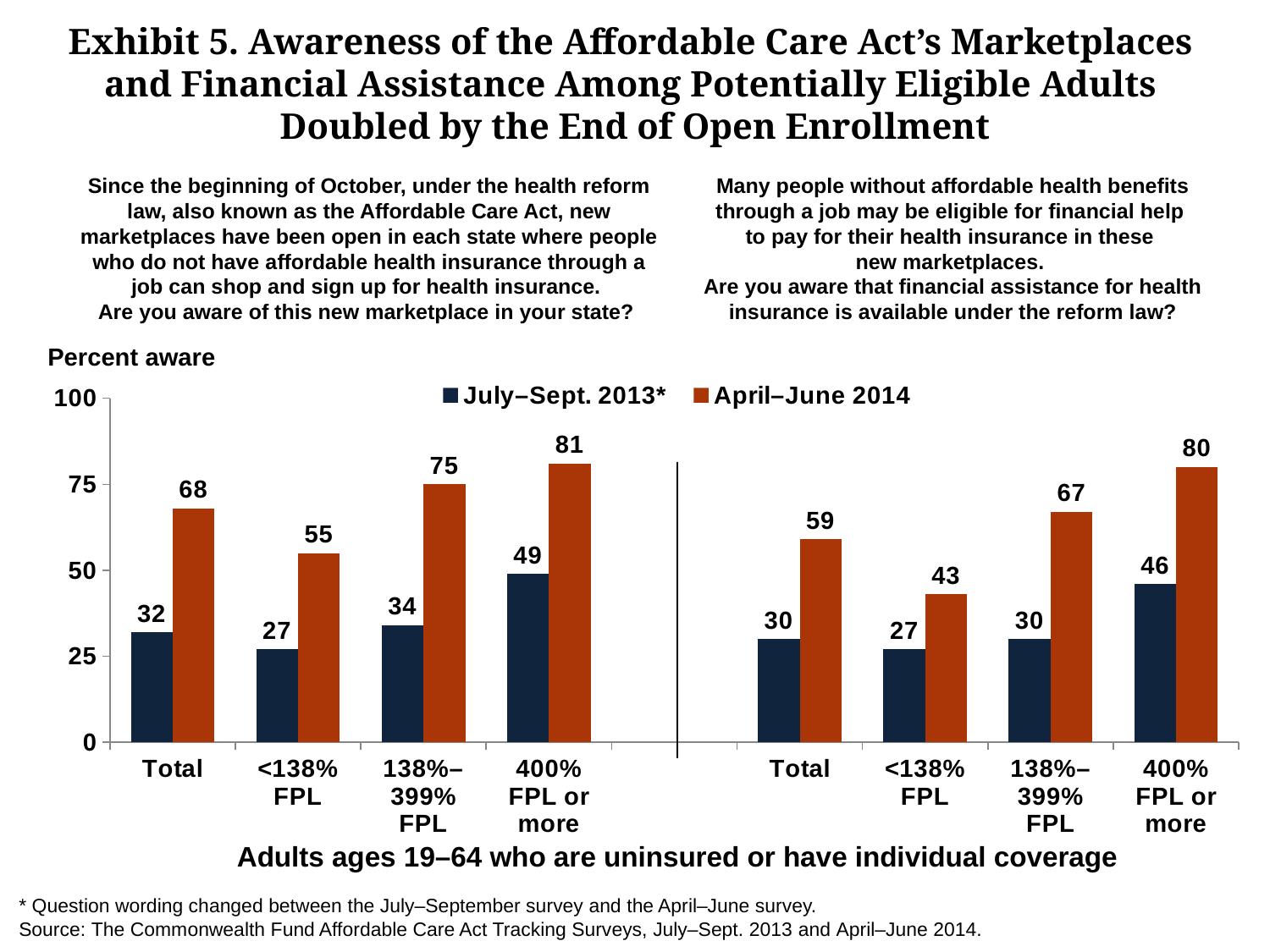
How many income categories are shown in the left panel (awareness of the marketplace)? 4 In the right panel (awareness of financial assistance), is the April–June 2014 value for Total greater or less than 50? greater In the right panel (awareness of financial assistance), what is the value for 400% FPL or more in July–Sept. 2013? 46 In the left panel (awareness of the marketplace), which is larger: the July–Sept. 2013 value for 400% FPL or more or the July–Sept. 2013 value for 138%–399% FPL? 400% FPL or more In the left panel (awareness of the marketplace), what is the value for Total in April–June 2014? 68 In the left panel (awareness of the marketplace), which income group has the highest April–June 2014 value? 400% FPL or more In the left panel (awareness of the marketplace), what is the difference between the April–June 2014 and July–Sept. 2013 values for Total? 36 In the right panel (awareness of financial assistance), which income group has the lowest April–June 2014 value? <138% FPL How many series does the legend list? 2 In the right panel (awareness of financial assistance), what is the difference between the April–June 2014 and July–Sept. 2013 values for 138%–399% FPL? 37 What kind of chart is shown on the slide? Bar chart What is the label on the y axis of the chart? Percent aware